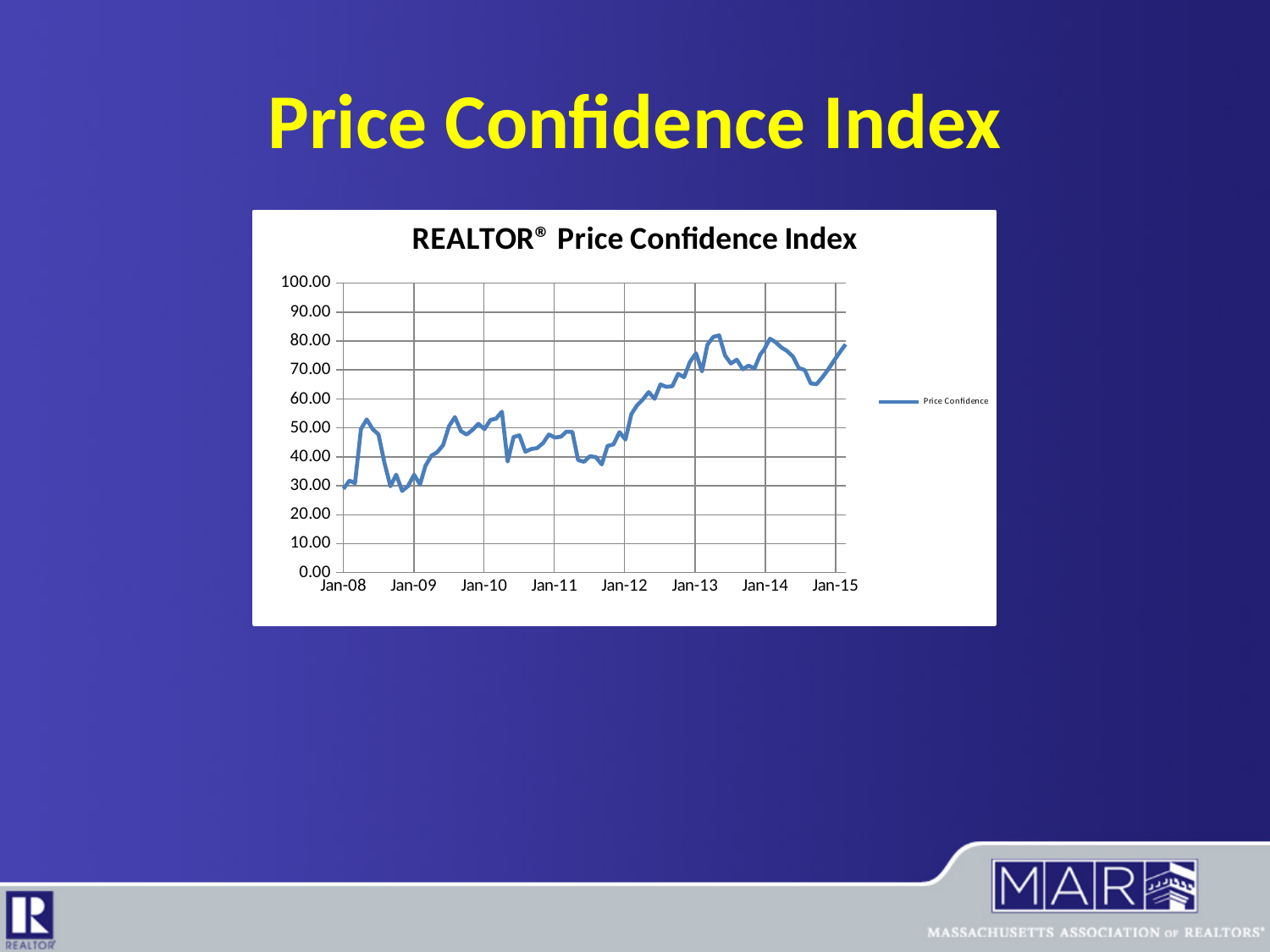
What is the title of the chart? REALTOR® Price Confidence Index Is the value for Jan-13 greater or less than 70? greater Overall, does the Price Confidence line rise or fall from Jan-08 to Jan-15? rise What is the name of the series shown in the legend? Price Confidence What kind of chart is shown on the slide? line chart Is the value for Jan-14 greater or less than 70? greater Is the value for Jan-15 greater or less than 60? greater How many series does the legend list? 1 How many year labels are shown on the x axis? 8 Which is larger, the value at Jan-08 or the value at Jan-14? Jan-14